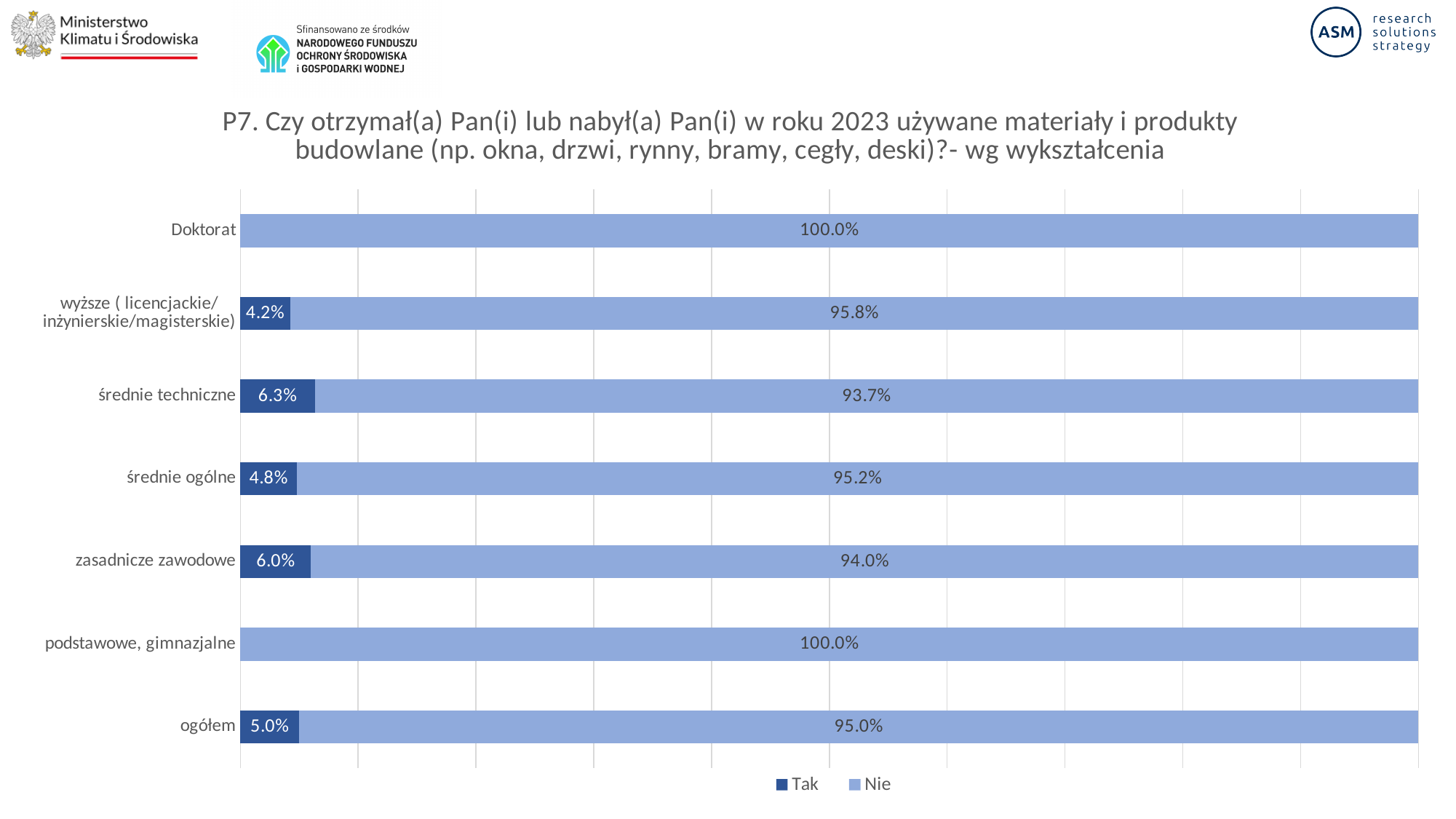
What is the "Nie" value for Doktorat? 100.0% How many series does the legend list? 2 What is the "Tak" value for ogółem? 5.0% Which education category has the highest "Tak" value? średnie techniczne How many education categories are shown on the chart? 7 What kind of chart is shown on the slide? Stacked bar chart What is the "Tak" value for średnie techniczne? 6.3% What is the "Nie" value for wyższe (licencjackie/inżynierskie/magisterskie)? 95.8% Among the categories with a "Tak" label, which has the lowest "Tak" value? wyższe (licencjackie/inżynierskie/magisterskie) Which is larger: the "Nie" value for średnie ogólne or for zasadnicze zawodowe? średnie ogólne What is the difference between the "Tak" values for zasadnicze zawodowe and średnie ogólne? 1.2% What is the total of the stacked bar for średnie techniczne? 100.0%